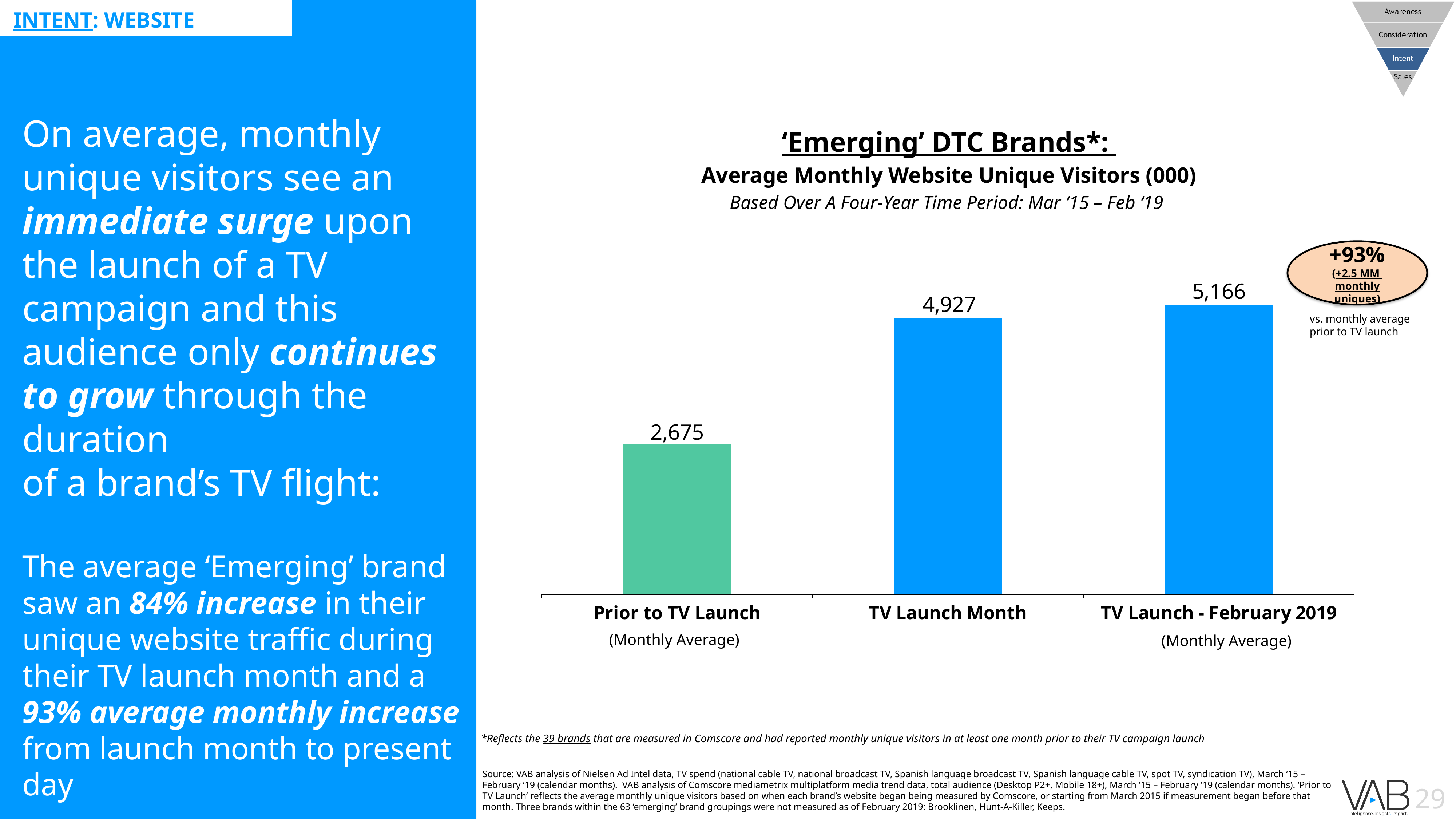
Which category has the highest average monthly website unique visitors? TV Launch - February 2019 What is the average monthly website unique visitors (000) for Prior to TV Launch? 2,675 What is the average monthly website unique visitors (000) for TV Launch Month? 4,927 What is the average monthly website unique visitors (000) for TV Launch - February 2019? 5,166 Do the values rise or fall from left to right across the chart? Rise What kind of chart is shown on the slide? Bar chart What is the difference in average monthly website unique visitors (000) between TV Launch - February 2019 and TV Launch Month? 239 Which is larger: the value for TV Launch Month or the value for Prior to TV Launch? TV Launch Month What percentage increase is shown in the callout next to the TV Launch - February 2019 bar? +93% How many categories are shown on the chart? 3 Which category has the lowest average monthly website unique visitors? Prior to TV Launch What is the difference in average monthly website unique visitors (000) between TV Launch Month and Prior to TV Launch? 2,252